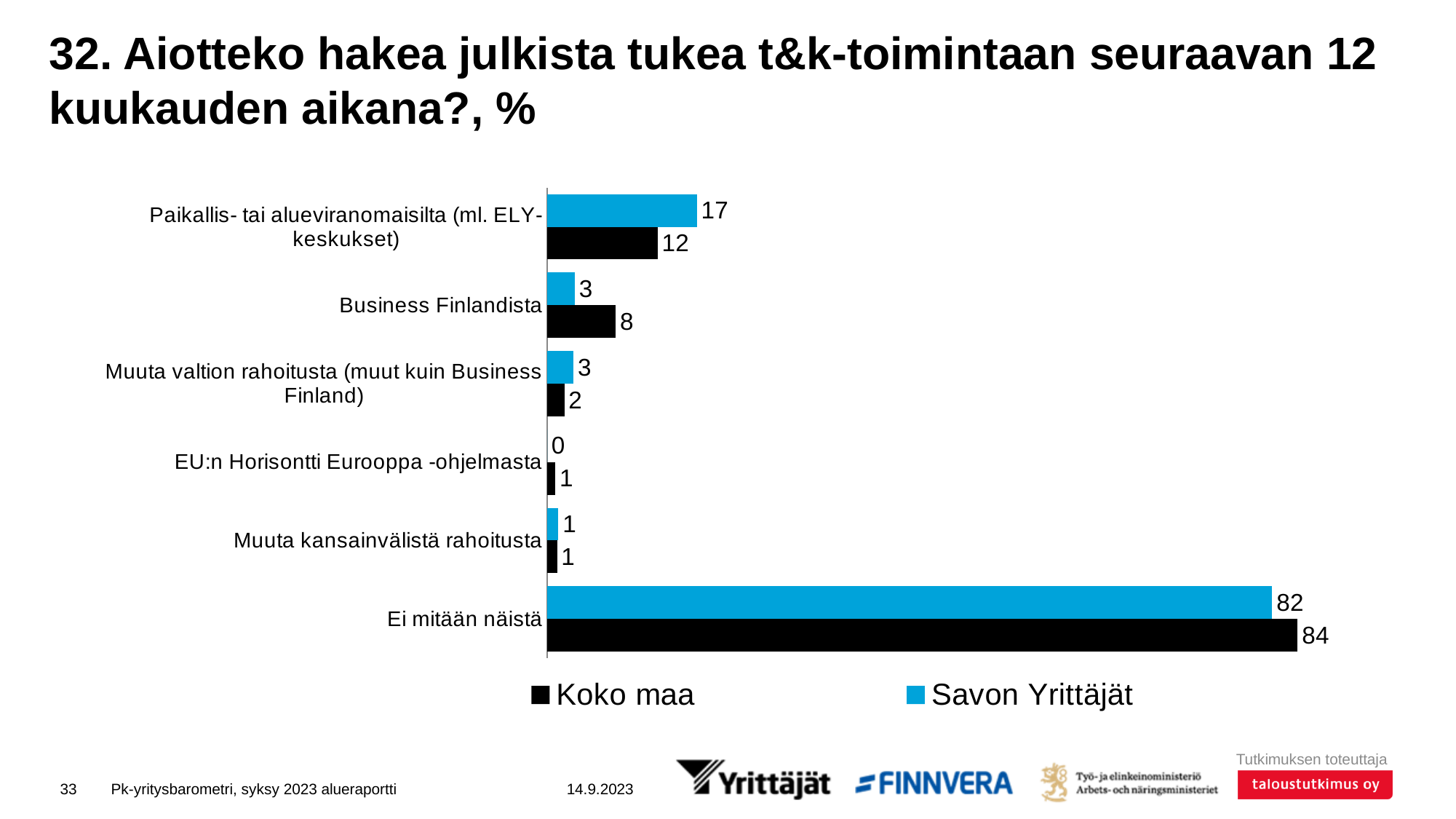
What is the value for Koko maa for 'Ei mitään näistä'? 84 How many series does the legend list? 2 What is the value for Savon Yrittäjät for 'Paikallis- tai alueviranomaisilta (ml. ELY-keskukset)'? 17 Which is larger for 'Business Finlandista': Koko maa or Savon Yrittäjät? Koko maa Which colour represents Savon Yrittäjät in the chart? Blue Which category has the lowest value for Koko maa? EU:n Horisontti Eurooppa -ohjelmasta and Muuta kansainvälistä rahoitusta (both 1) What kind of chart is shown on the slide? Bar chart What is the value for Savon Yrittäjät for 'EU:n Horisontti Eurooppa -ohjelmasta'? 0 How many categories are shown on the chart? 6 Which category has the highest value for Savon Yrittäjät? Ei mitään näistä What is the value for Koko maa for 'Business Finlandista'? 8 What is the difference between Savon Yrittäjät and Koko maa for 'Paikallis- tai alueviranomaisilta (ml. ELY-keskukset)'? 5